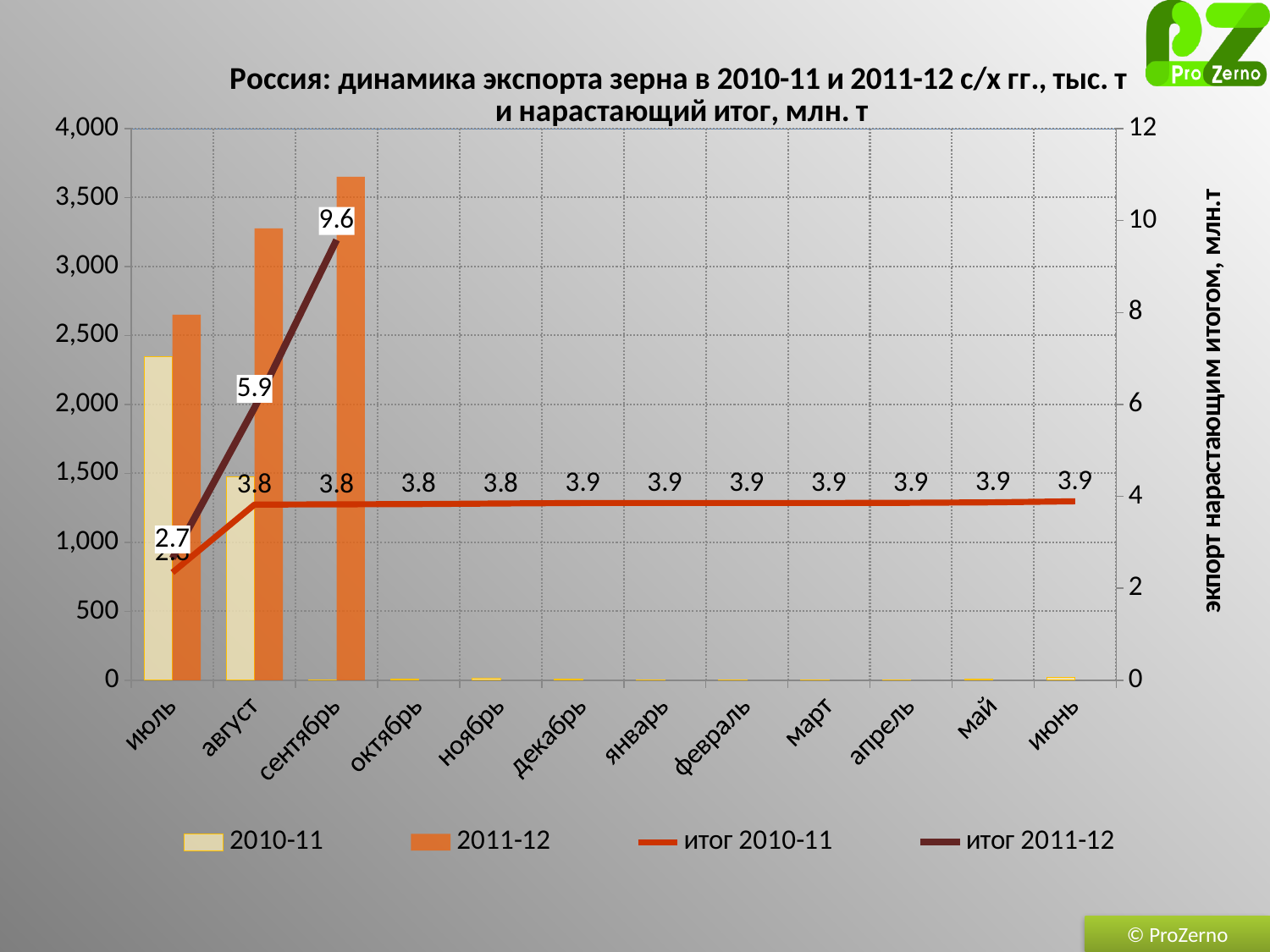
How many months are shown on the x axis? 12 In июль, which bar is taller: 2010-11 or 2011-12? 2011-12 What is the value of итог 2010-11 in июнь? 3.9 What is the value of итог 2011-12 in август? 5.9 What is the value of итог 2010-11 in октябрь? 3.8 Is the 2011-12 bar for сентябрь greater or less than 3,500? greater In сентябрь, how much higher is итог 2011-12 than итог 2010-11? 5.8 How many series does the legend list? 4 What is the difference between the итог 2011-12 values for сентябрь and август? 3.7 Is the 2010-11 bar for август greater or less than 2,000? less What is the value of итог 2011-12 in сентябрь? 9.6 In which month is the 2011-12 bar the highest? сентябрь